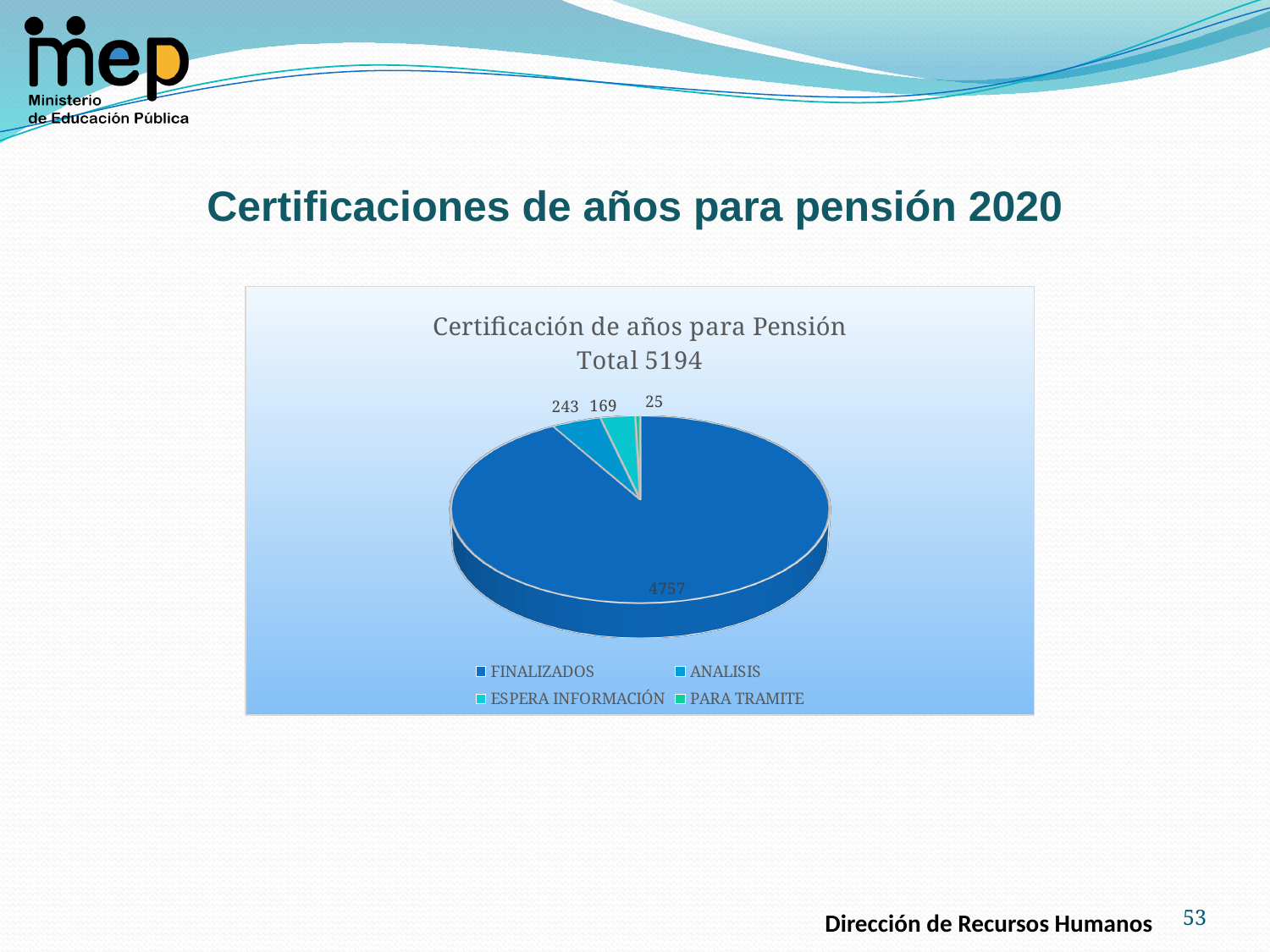
What kind of chart is shown on the slide? pie chart What is the value for ESPERA INFORMACIÓN in the pie chart? 169 What is the title of the chart? Certificación de años para Pensión Total 5194 What is the value for PARA TRAMITE in the pie chart? 25 How many categories does the pie chart show? 4 What is the difference between the values for ANALISIS and ESPERA INFORMACIÓN? 74 What is the value for ANALISIS in the pie chart? 243 Which category has the largest slice of the pie chart? FINALIZADOS Which is larger, the value for ANALISIS or the value for PARA TRAMITE? ANALISIS What is the value for FINALIZADOS in the pie chart? 4757 Which category has the smallest slice of the pie chart? PARA TRAMITE What total is stated in the chart title? 5194